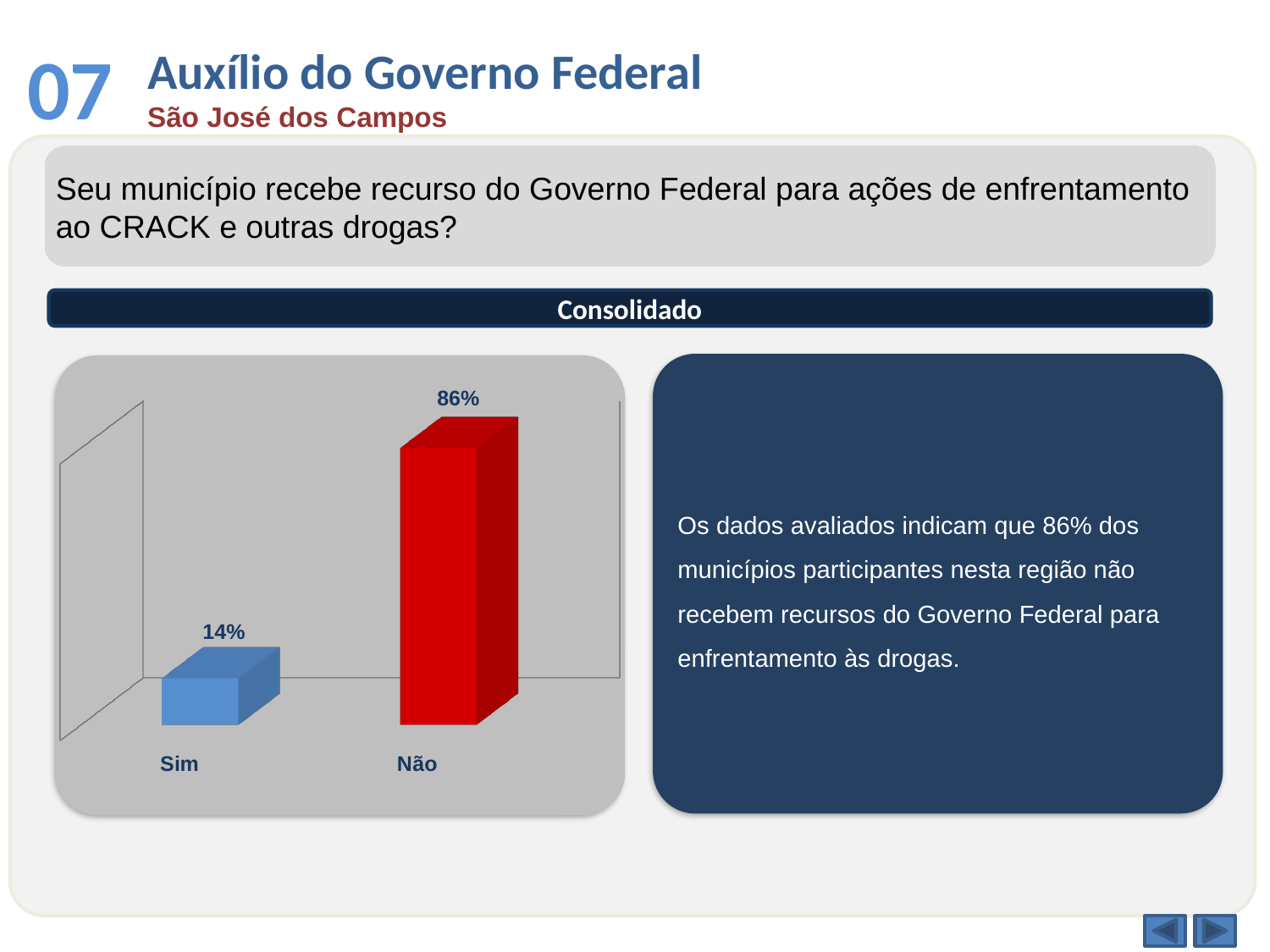
What is the value for Sim? 14% What is the difference between the values for Não and Sim? 72% Which category has the highest value? Não How many categories are shown in the chart? 2 What colour is the bar for Não? red What colour is the bar for Sim? blue Which category has the lowest value? Sim Which is larger, the value for Sim or the value for Não? Não What is the total of the values for Sim and Não? 100% What kind of chart is shown on the slide? bar chart What is the value for Não? 86%